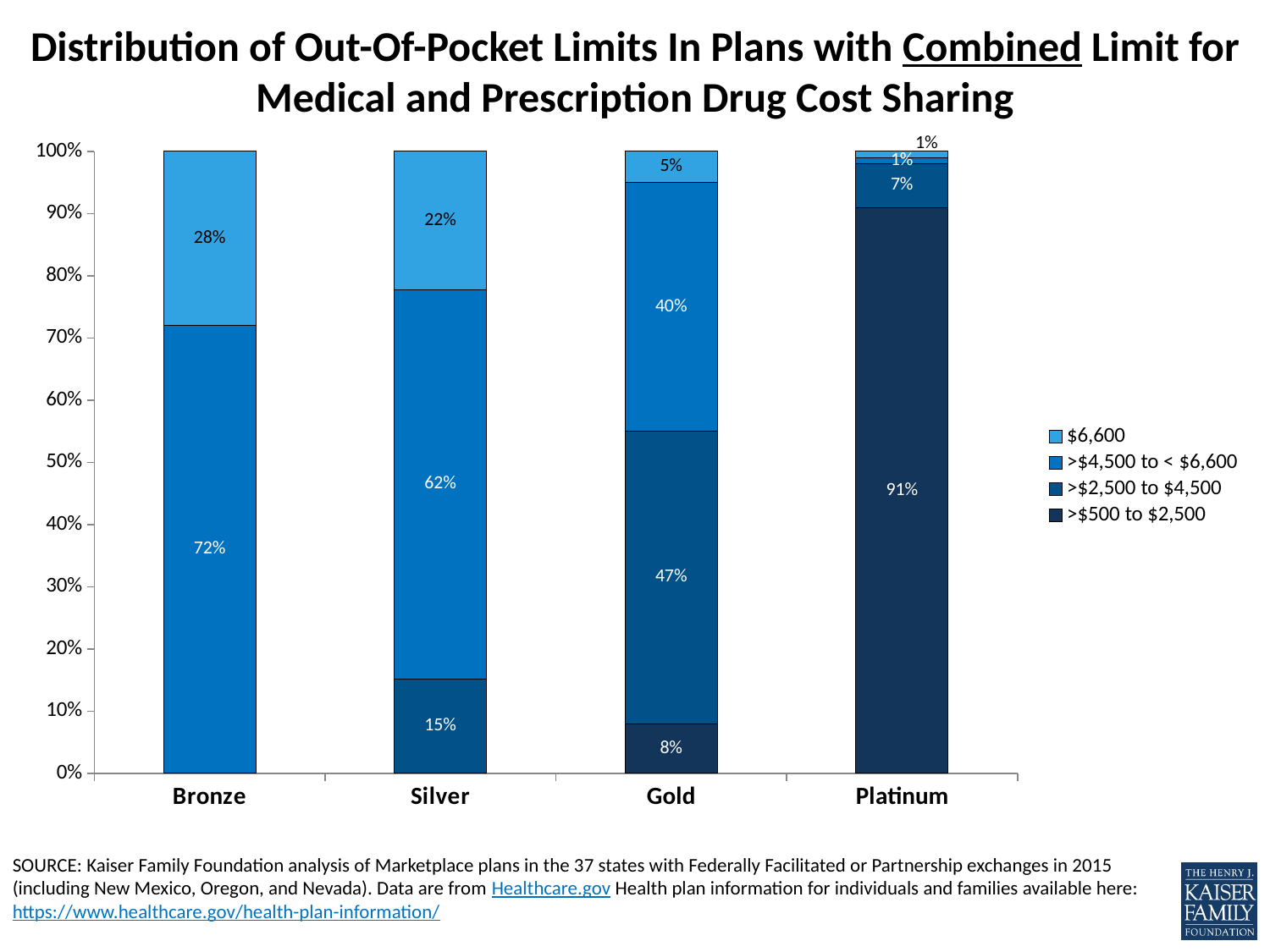
What percentage of Platinum plans have an out-of-pocket limit of >$500 to $2,500? 91% How many metal tiers are shown on the x axis? 4 What percentage of Bronze plans have an out-of-pocket limit of $6,600? 28% What type of chart is shown on the slide? Stacked bar chart Which is larger: the share of Gold plans with a limit of >$2,500 to $4,500 or the share of Gold plans with a limit of >$4,500 to < $6,600? >$2,500 to $4,500 How many out-of-pocket limit ranges does the legend list? 4 What percentage of Gold plans have an out-of-pocket limit of >$500 to $2,500? 8% Which metal tier has the highest share of plans with a $6,600 out-of-pocket limit? Bronze What percentage of Gold plans have an out-of-pocket limit of >$2,500 to $4,500? 47% What percentage of Silver plans have an out-of-pocket limit of >$4,500 to < $6,600? 62% What is the difference between the share of Bronze plans and the share of Silver plans with a $6,600 out-of-pocket limit? 6 percentage points Which metal tier has the lowest share of plans with an out-of-pocket limit of >$4,500 to < $6,600? Platinum